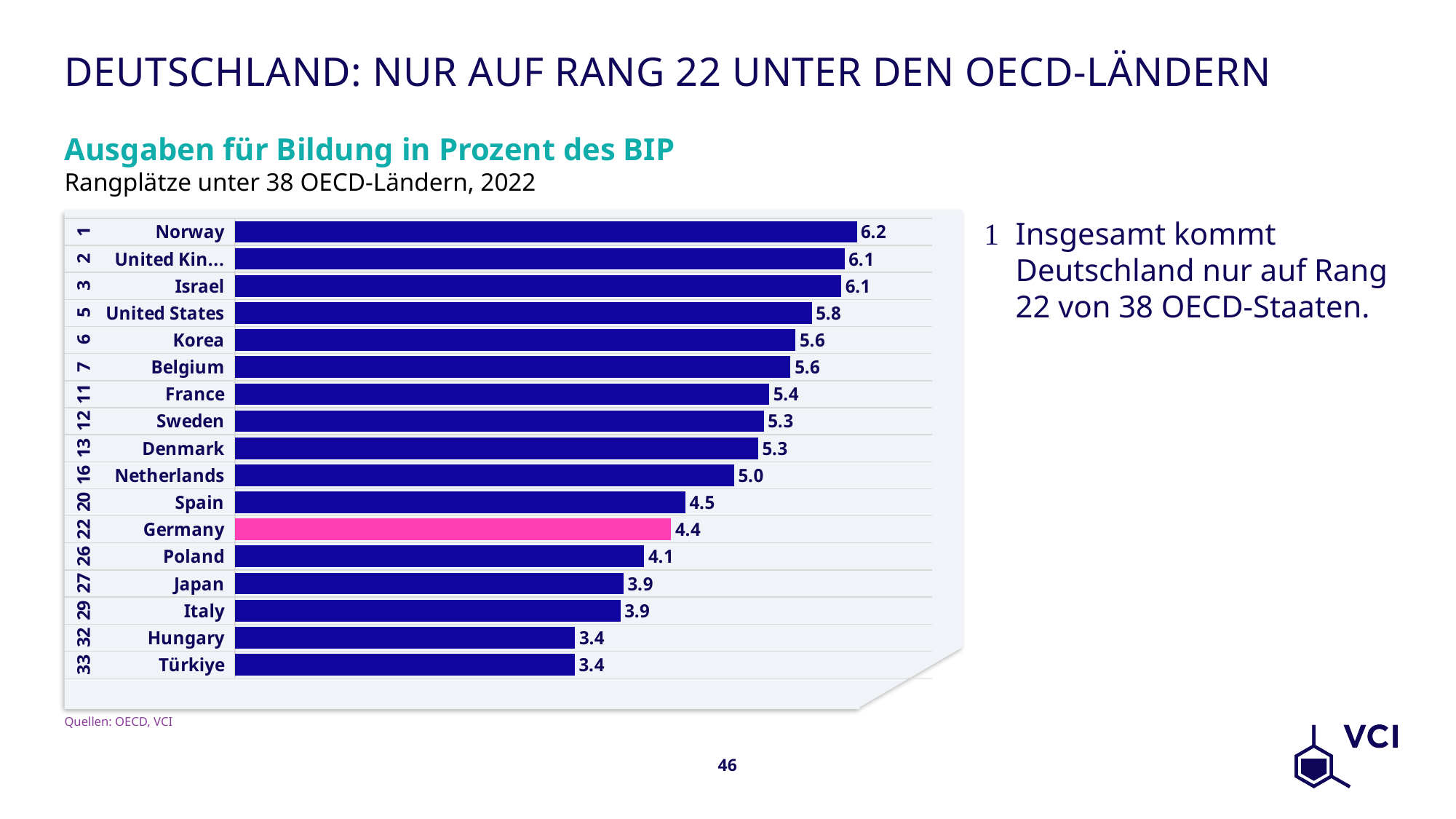
What kind of chart is shown on the slide? Bar chart Which is larger, the value for Spain or the value for Japan? Spain Which is larger, the value for Korea or the value for Sweden? Korea What is the value for Norway? 6.2 How many countries are shown in the chart? 17 What is the difference between the values for Norway and Germany? 1.8 What rank is shown next to Germany? 22 What is the value for Germany? 4.4 Which country's bar is highlighted in pink? Germany What is the difference between the values for United States and Poland? 1.7 Which country has the highest value? Norway What is the value for Netherlands? 5.0